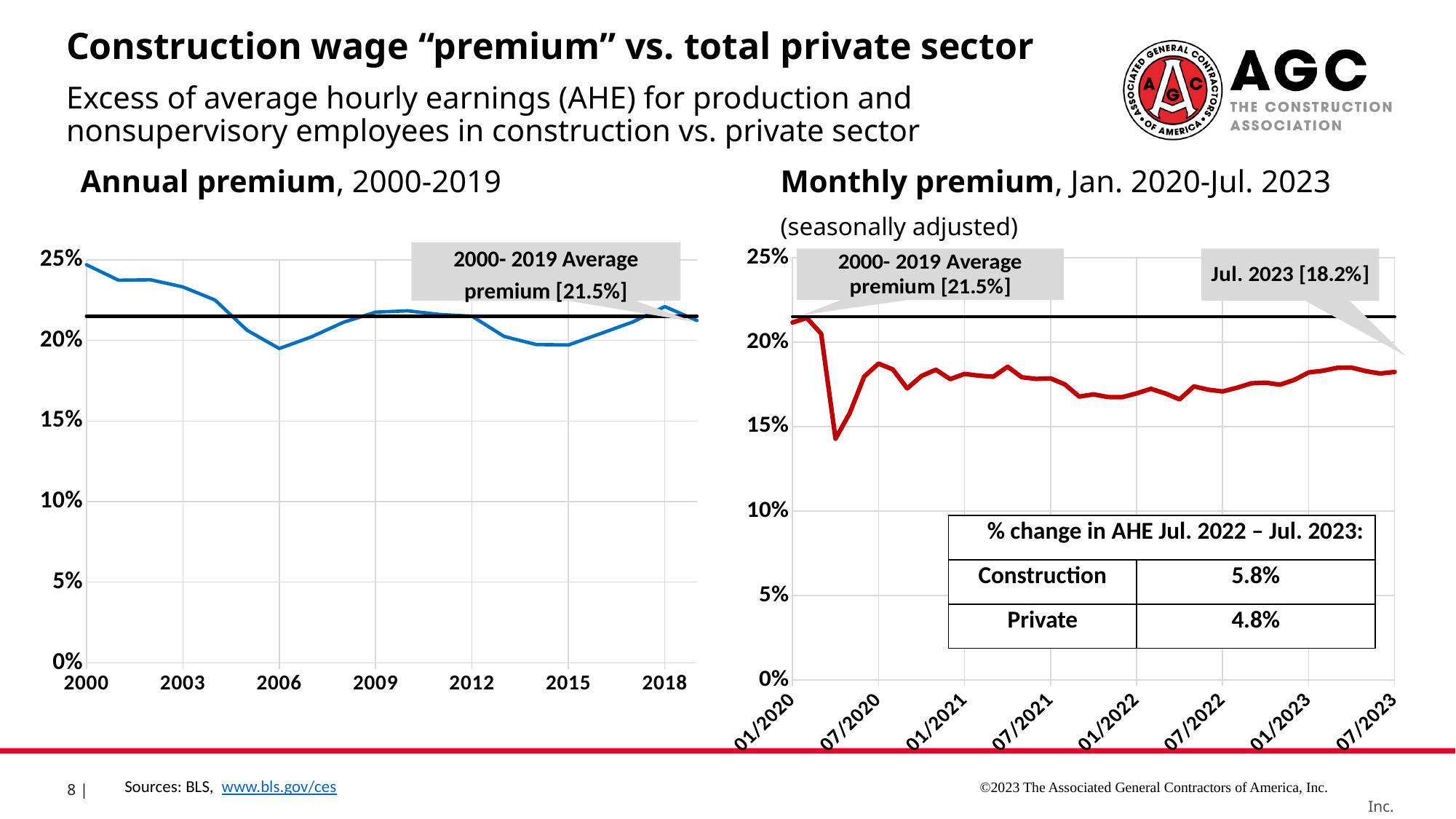
On the 'Monthly premium' chart, what is the premium value labelled for Jul. 2023? 18.2% What colour is the line on the 'Monthly premium, Jan. 2020-Jul. 2023' chart? red On the 'Monthly premium' chart, how much lower is the Jul. 2023 value than the 2000-2019 average premium? 3.3 percentage points On the 'Monthly premium' chart, which is larger: the Jul. 2023 value or the 2000-2019 average premium? the 2000-2019 average premium On the 'Monthly premium' chart, is the lowest point of the line (in 2020) greater or less than 15%? less On the 'Annual premium, 2000-2019' chart, is the value for 2000 greater or less than 20%? greater On the 'Monthly premium' chart, does the premium rise or fall between 01/2020 and 07/2020? fall On the 'Annual premium, 2000-2019' chart, what is the 2000-2019 average premium shown by the horizontal line? 21.5% On the 'Annual premium, 2000-2019' chart, is the value for 2006 greater or less than 20%? less On the 'Annual premium, 2000-2019' chart, which year has the highest premium? 2000 What kind of chart is the 'Monthly premium, Jan. 2020-Jul. 2023' chart on the right? line chart What kind of chart is the 'Annual premium, 2000-2019' chart on the left? line chart